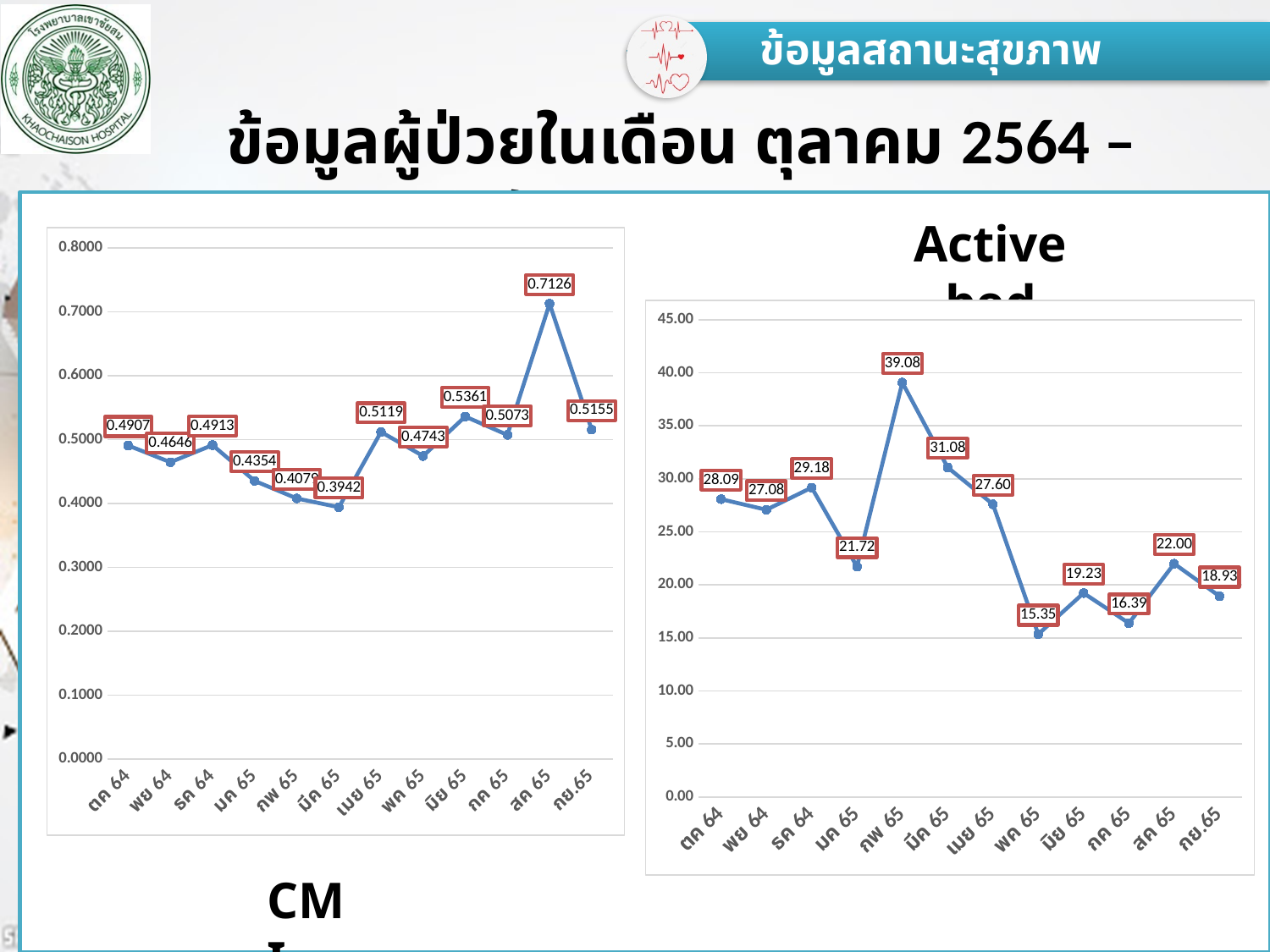
On the Active bed chart, which month has the lowest value? พค 65 On the left chart, what is the difference between the values for สค 65 and กย.65? 0.1971 On the Active bed chart, what is the value for กพ 65? 39.08 On the left chart, what is the value for มิย 65? 0.5361 On the left chart, which month has the highest value? สค 65 On the Active bed chart, which is larger, the value for ตค 64 or the value for พย 64? ตค 64 On the left chart, which month has the lowest value? มีค 65 On the Active bed chart, which month has the highest value? กพ 65 How many months are plotted on the Active bed chart? 12 On the left chart, what is the value for สค 65? 0.7126 On the Active bed chart, what is the difference between the values for กพ 65 and มีค 65? 8.00 On the Active bed chart, is the value for มค 65 greater or less than 25.00? less